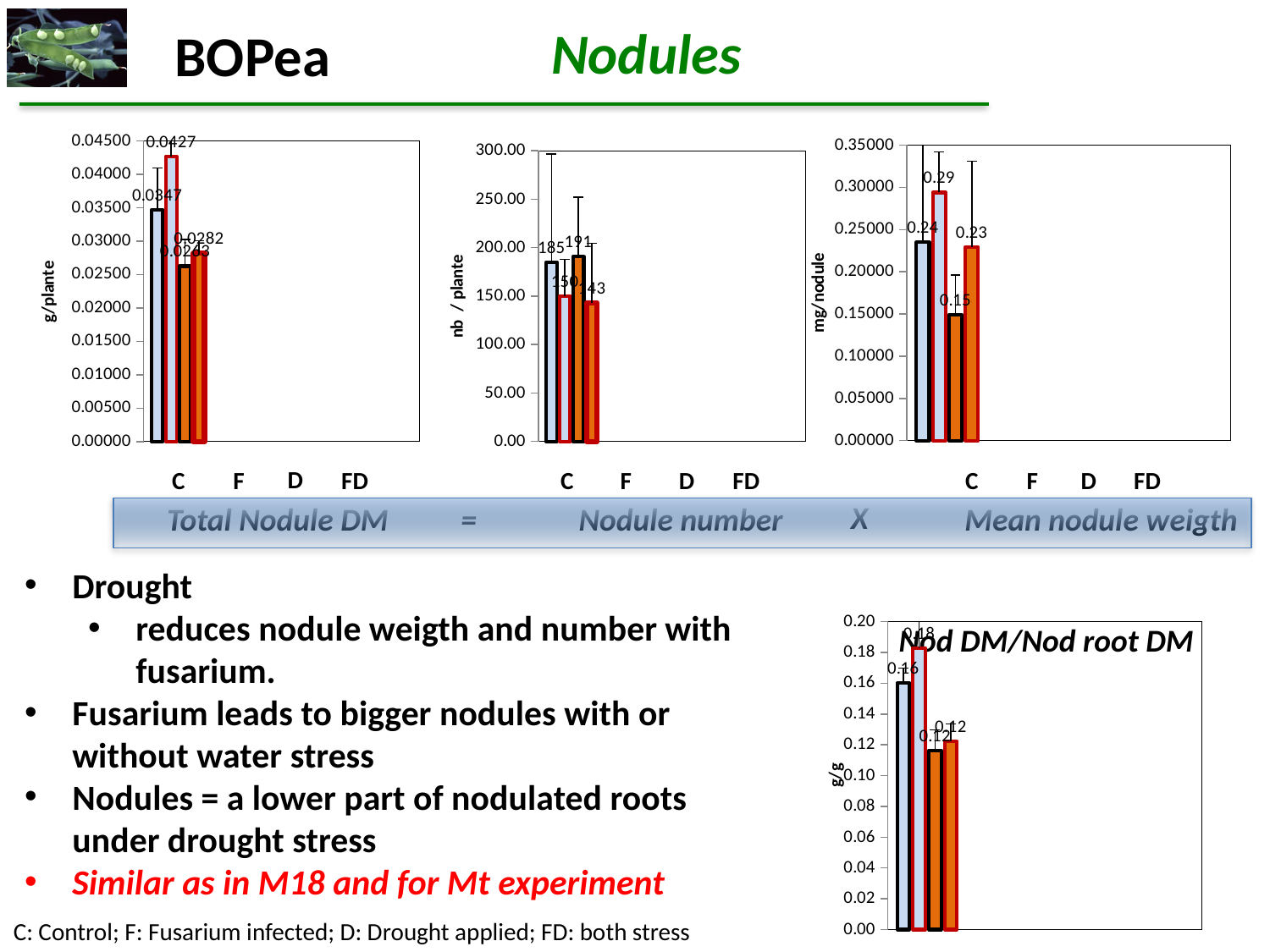
In the Nod DM/Nod root DM chart, what is the value for C? 0.16 In the Total Nodule DM chart, which category has the highest value? F In the Nodule number chart, what is the difference between the values for C and F? 35 What kind of chart is the Mean nodule weight chart? bar chart In the Nodule number chart, what is the value for FD? 143 In the Nodule number chart, which category has the highest value? D In the Nod DM/Nod root DM chart, what is the difference between the values for F and D? 0.06 In the Mean nodule weight chart, which category has the lowest value? D In the Total Nodule DM chart, what is the value for F? 0.0427 In the Nodule number chart, is the value for F greater or less than 200? less In the Mean nodule weight chart, what is the value for F? 0.29 How many categories are shown on the x axis of the Nodule number chart? 4